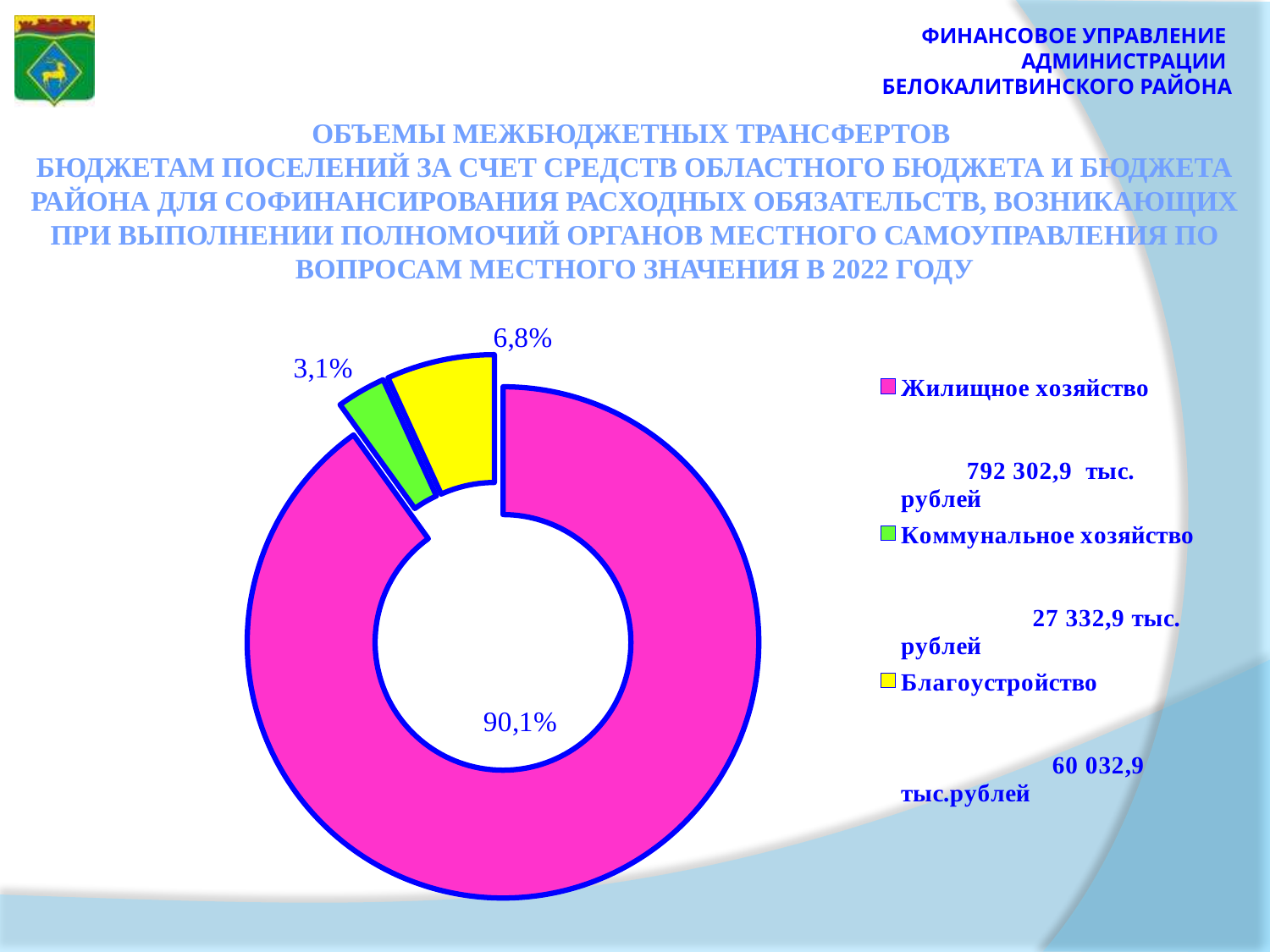
What share of the pie does Жилищное хозяйство account for? 90,1% What kind of chart is shown on the slide? Doughnut (pie) chart How many categories are shown in the chart? 3 What share of the pie does Благоустройство account for? 6,8% What is the amount shown in the legend for Коммунальное хозяйство? 27 332,9 тыс. рублей What is the amount shown in the legend for Жилищное хозяйство? 792 302,9 тыс. рублей What share of the pie does Коммунальное хозяйство account for? 3,1% Which category has the largest slice of the chart? Жилищное хозяйство Which category has the smallest slice of the chart? Коммунальное хозяйство Which slice is larger: Благоустройство or Коммунальное хозяйство? Благоустройство What is the amount shown in the legend for Благоустройство? 60 032,9 тыс.рублей What is the difference in percentage points between the Благоустройство and Коммунальное хозяйство slices? 3,7%